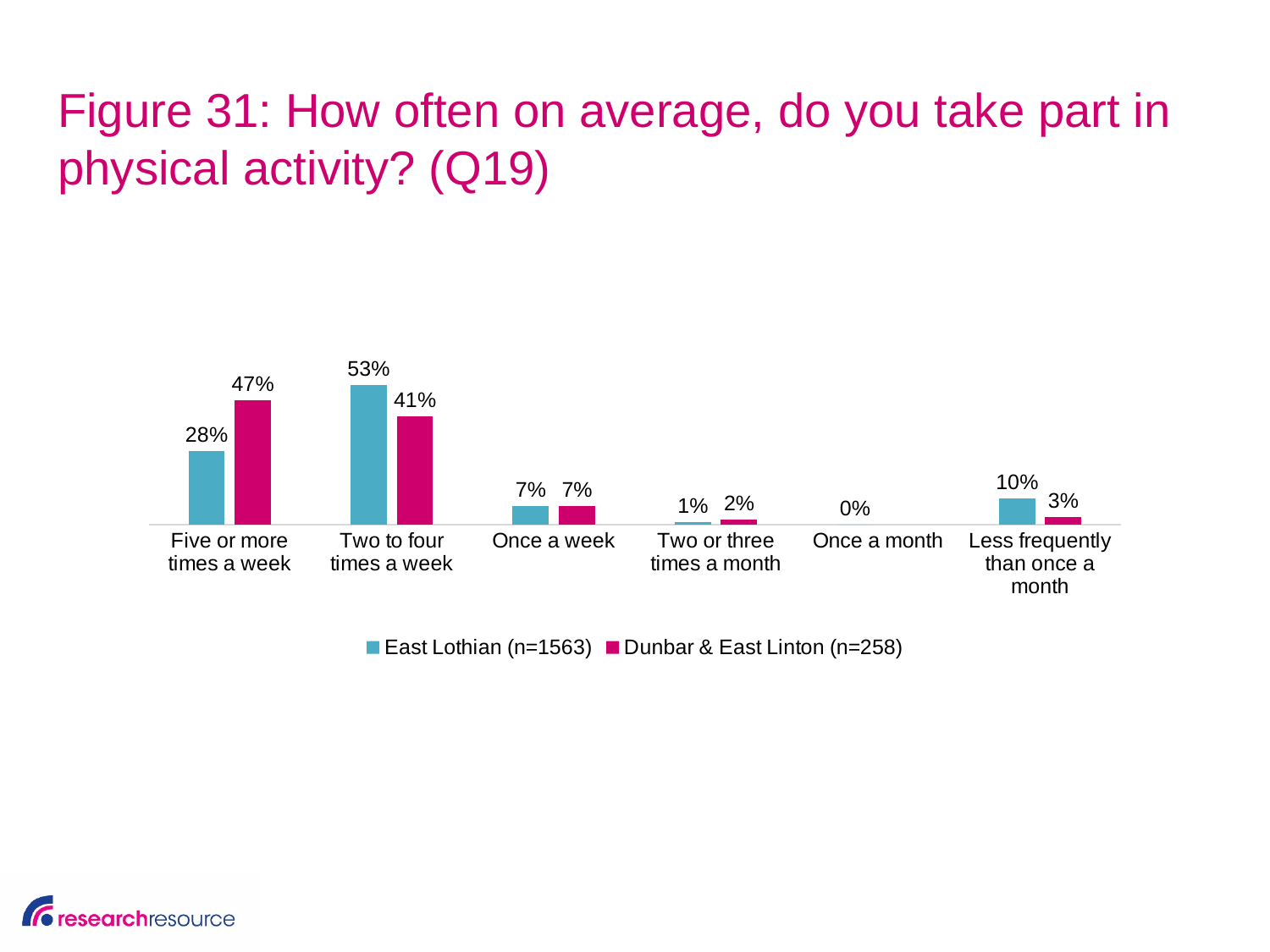
What percentage of East Lothian respondents take part in physical activity five or more times a week? 28% What is the value for Dunbar & East Linton for 'Less frequently than once a month'? 3% For 'Less frequently than once a month', which series has the larger value, East Lothian or Dunbar & East Linton? East Lothian What kind of chart is shown on the slide? Bar chart What is the difference between the East Lothian and Dunbar & East Linton values for 'Two to four times a week'? 12 percentage points How many response categories are shown on the x axis? 6 Which category has the highest value for East Lothian? Two to four times a week How many series does the legend list? 2 Which category has the highest value for Dunbar & East Linton? Five or more times a week What is the difference between the Dunbar & East Linton and East Lothian values for 'Five or more times a week'? 19 percentage points What percentage of Dunbar & East Linton respondents take part in physical activity two to four times a week? 41% What is the sample size (n) for the East Lothian series shown in the legend? 1563